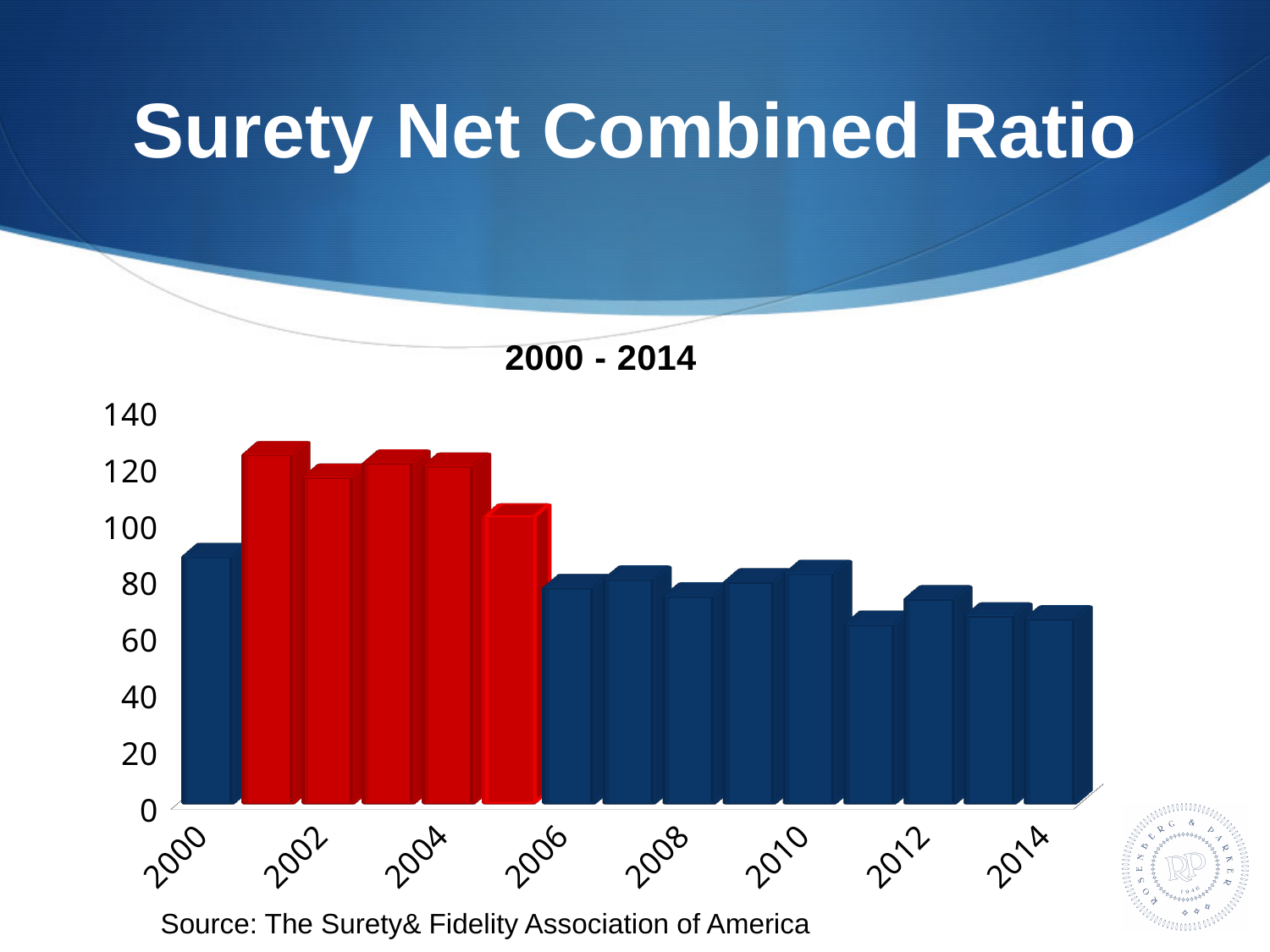
Which is larger, the value for 2000 or the value for 2011? 2000 Is the value for 2003 greater or less than 100? greater Which year has the lowest surety net combined ratio? 2011 What kind of chart is shown on the slide? bar chart Do the values rise or fall from 2001 to 2006? fall How many years (bars) are plotted in the chart? 15 Is the value for 2014 greater or less than 80? less How many bars are coloured red in the chart? 5 Is the value for 2000 greater or less than 100? less Which is larger, the value for 2001 or the value for 2006? 2001